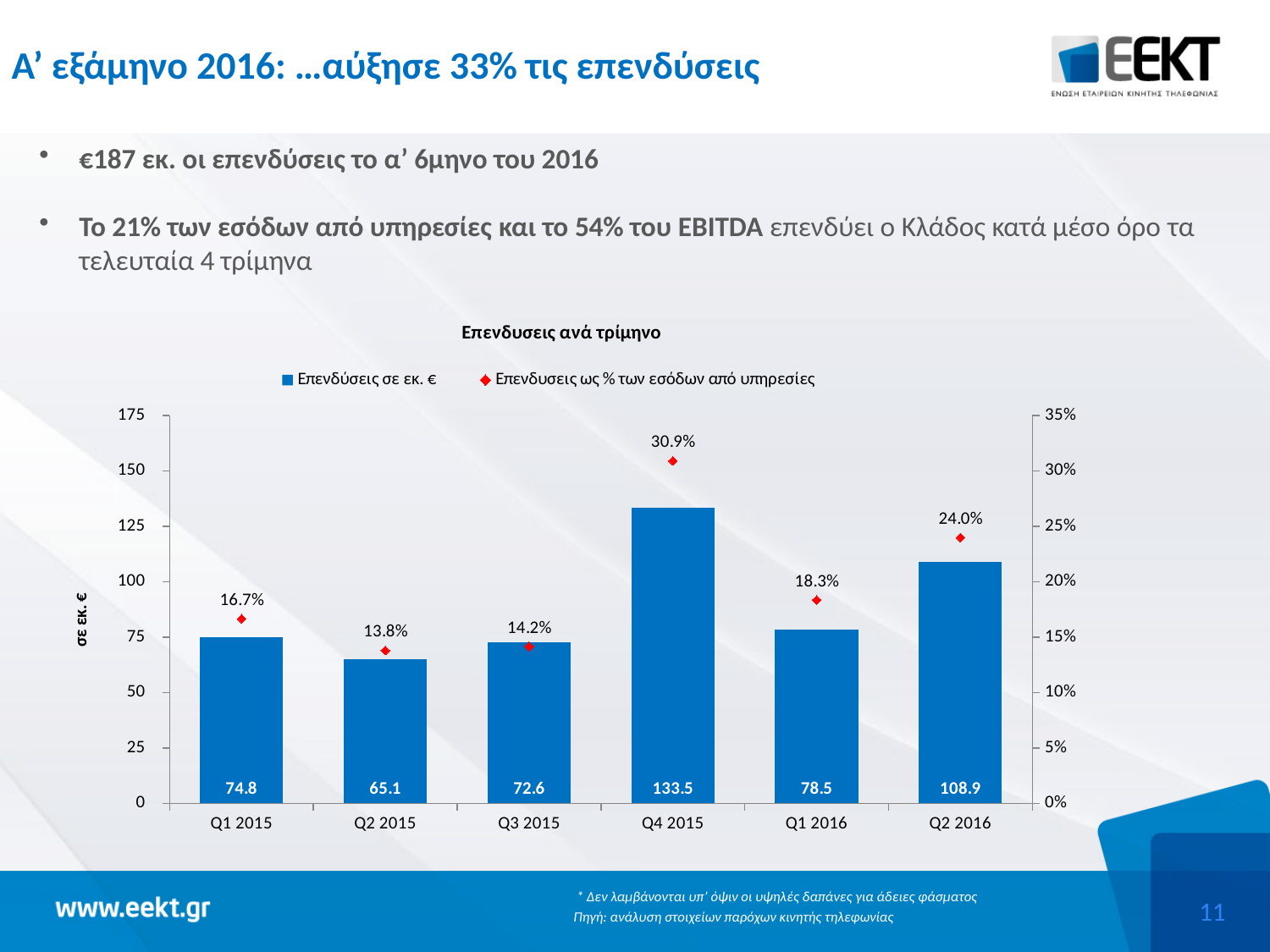
How many quarters are shown on the x axis of the chart? 6 Which quarter has the larger investment in million euros, Q1 2015 or Q3 2015? Q1 2015 What kind of chart is used to show the investments in million euros? Bar chart Which quarter has the highest investment in million euros? Q4 2015 Does the investment in million euros rise or fall from Q1 2016 to Q2 2016? Rise What is the investment value in million euros for Q2 2015? 65.1 Which quarter has the lowest investment as a percentage of service revenues? Q2 2015 What is the difference in investment (million euros) between Q2 2016 and Q1 2016? 30.4 What is the investment as a percentage of service revenues (Επενδυσεις ως % των εσόδων από υπηρεσίες) for Q2 2016? 24.0% How many series does the chart legend list? 2 What is the title of the chart? Επενδυσεις ανά τρίμηνο What is the investment value in million euros (Επενδύσεις σε εκ. €) for Q4 2015? 133.5